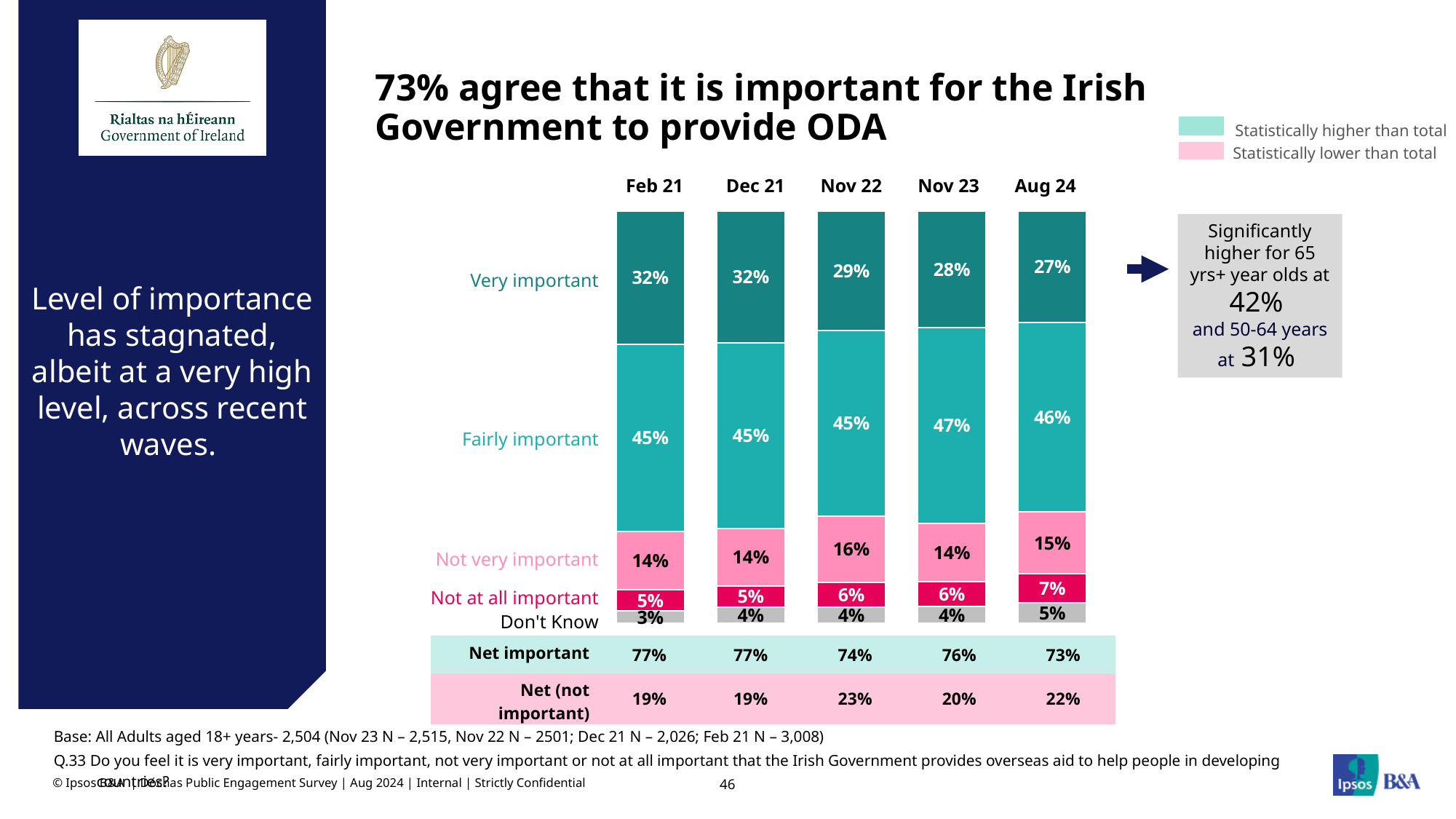
What percentage said 'Not very important' in Nov 22? 16% What is the 'Net important' value for Aug 24? 73% What type of chart is shown on the slide? Stacked bar chart What percentage said 'Very important' in Aug 24? 27% What is the 'Don't Know' value for Feb 21? 3% What is the difference between the 'Very important' share in Feb 21 and in Aug 24? 5 percentage points What percentage said 'Fairly important' in Nov 23? 47% In which wave is the 'Very important' share highest? Feb 21 and Dec 21 (32%) How many response categories are stacked in each bar? 5 Which is larger: 'Fairly important' in Nov 23 or 'Fairly important' in Aug 24? Nov 23 How many survey waves are shown in the chart? 5 In which wave is the 'Not at all important' share highest? Aug 24